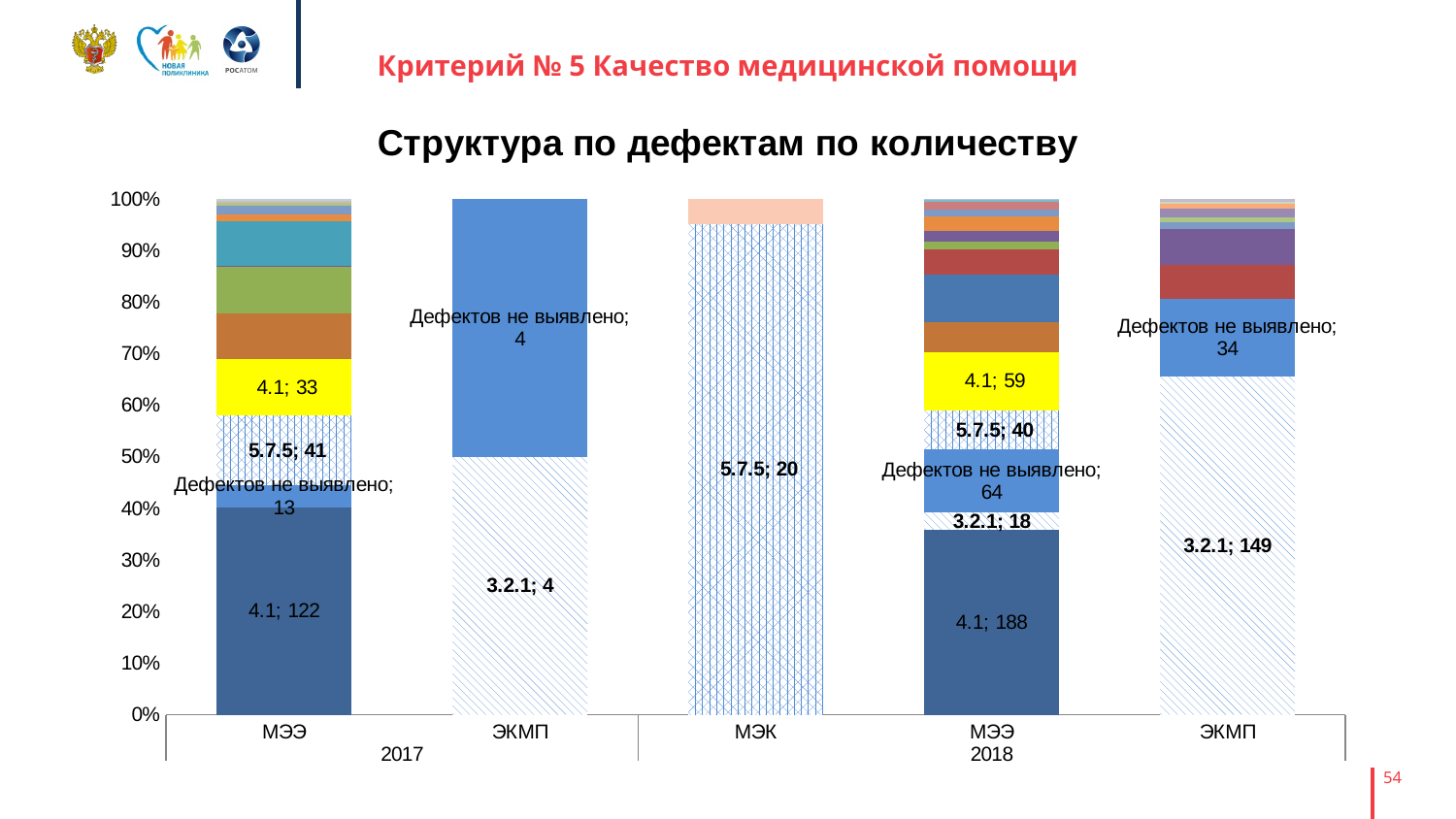
What is the value of the "Дефектов не выявлено" segment in the МЭЭ 2018 bar? 64 What is the title of the chart? Структура по дефектам по количеству Is the share of the "3.2.1" segment in the ЭКМП 2018 bar greater or less than 50%? greater How many bars (categories) are plotted along the x axis? 5 What is the value of the "3.2.1" segment in the ЭКМП 2018 bar? 149 Which two years are shown as groups on the x axis? 2017 and 2018 Which is larger: the "5.7.5" segment in МЭЭ 2017 or the "5.7.5" segment in МЭЭ 2018? МЭЭ 2017 What is the value of the "5.7.5" segment in the МЭК bar? 20 What is the value of the "Дефектов не выявлено" segment in the ЭКМП 2017 bar? 4 What is the difference between the "4.1" bottom segment of МЭЭ 2018 (188) and the "4.1" bottom segment of МЭЭ 2017 (122)? 66 What is the value of the "4.1" segment at the bottom of the МЭЭ 2017 bar? 122 What kind of chart is shown on the slide? Stacked bar chart